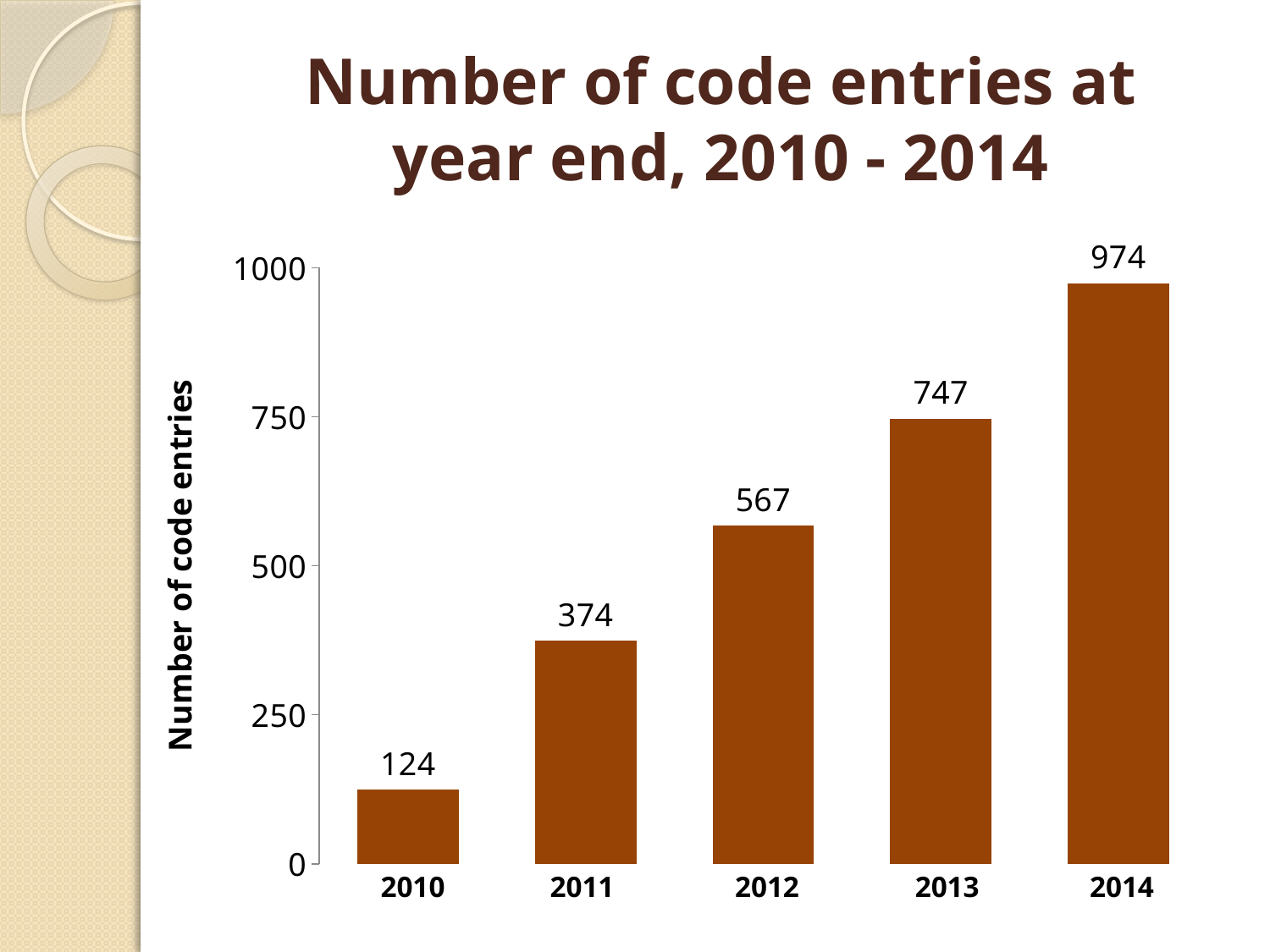
Which year has the lowest number of code entries? 2010 What is the title of the chart? Number of code entries at year end, 2010 - 2014 What is the number of code entries at year end for 2010? 124 Which year has more code entries, 2012 or 2013? 2013 What is the difference in code entries between 2011 and 2010? 250 Which year has the highest number of code entries? 2014 What is the number of code entries at year end for 2012? 567 How many years are shown on the x axis of the chart? 5 Do the number of code entries rise or fall from 2010 to 2014? rise Is the value for 2013 greater or less than 500? greater What kind of chart is shown on the slide? bar chart What is the difference in code entries between 2014 and 2013? 227